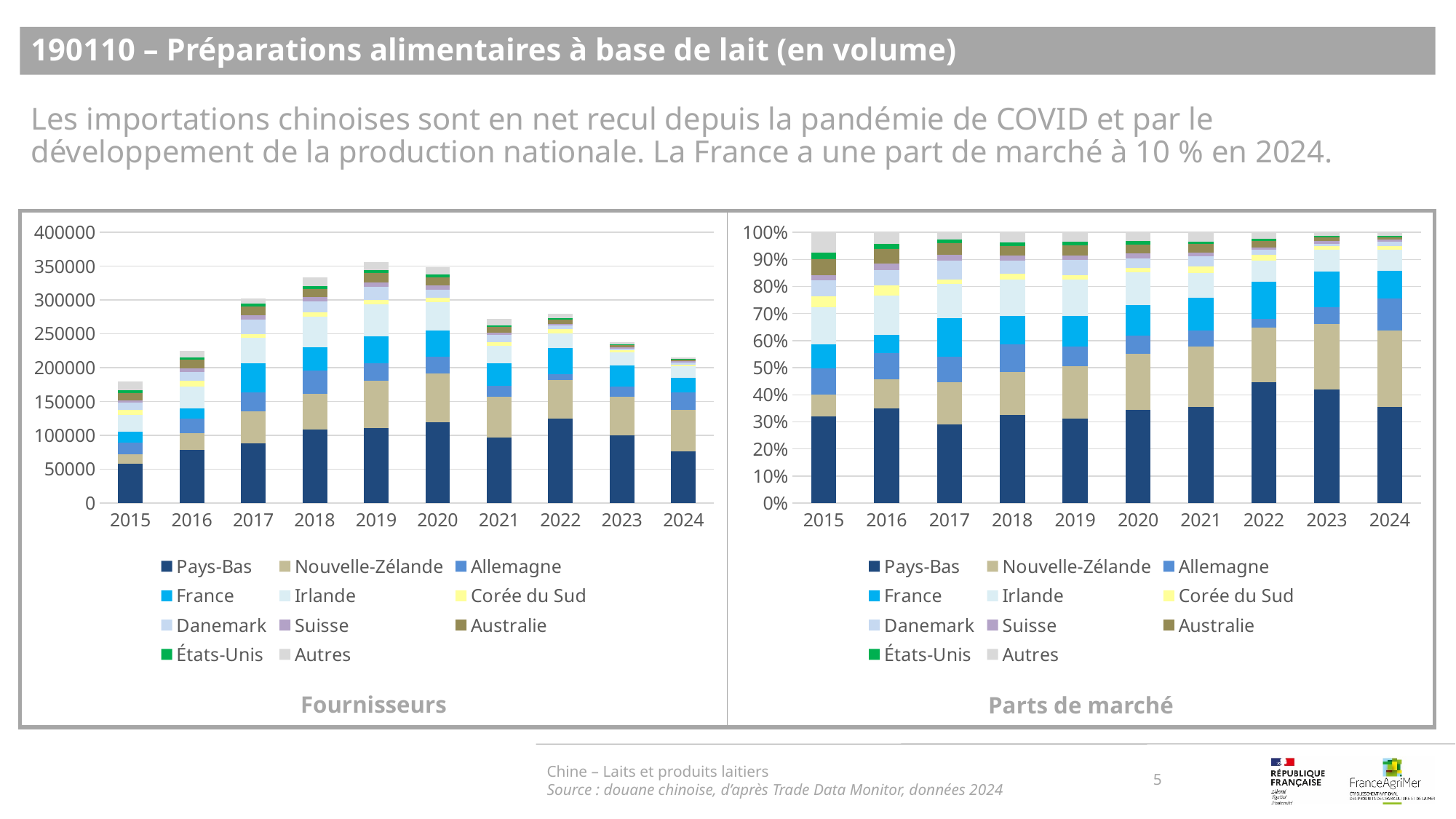
How many series does the legend of the 'Fournisseurs' chart list? 11 In the 'Parts de marché' chart, which is larger, the share of Pays-Bas in 2022 or in 2015? 2022 In the 'Fournisseurs' chart, do the total bars rise or fall from 2019 to 2024? fall In the 'Fournisseurs' chart, is the total for 2015 greater or less than 200000? less In the 'Parts de marché' chart, is the share of Pays-Bas in 2022 greater or less than 40%? greater Which series is shown at the bottom of each stacked bar in the 'Parts de marché' chart? Pays-Bas What kind of chart is the 'Fournisseurs' chart on the left? Stacked bar chart In the 'Fournisseurs' chart, is the total for 2024 greater or less than 250000? less In the 'Fournisseurs' chart, which total is larger, 2017 or 2024? 2017 In the 'Fournisseurs' chart, which year has the lowest total bar? 2015 How many years are shown on the x axis of the 'Parts de marché' chart? 10